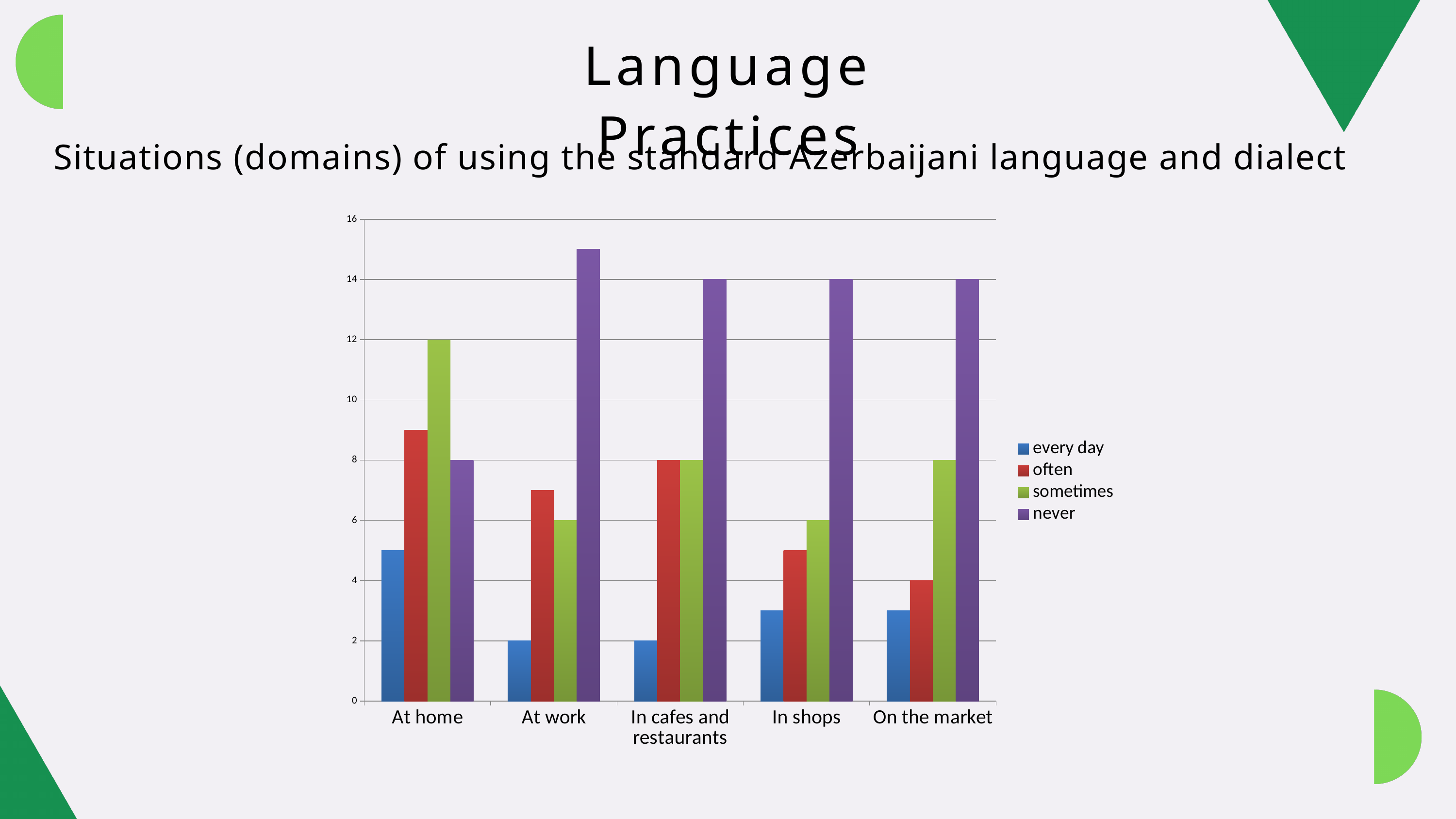
What is the difference between 'sometimes' in 'At home' and 'sometimes' in 'On the market'? 4 What is the value for 'often' in the 'On the market' category? 4 How many series does the legend list? 4 Which category has the highest 'every day' value? At home Which category has the highest 'never' value? At work How many categories are shown on the x axis? 5 Which is larger in the 'At home' category, 'sometimes' or 'never'? sometimes What is the value for 'sometimes' in the 'At home' category? 12 What is the value for 'every day' in the 'At work' category? 2 What kind of chart is shown on the slide? bar chart What is the value for 'never' in the 'In cafes and restaurants' category? 14 Is the value for 'never' in the 'At work' category greater or less than 14? greater